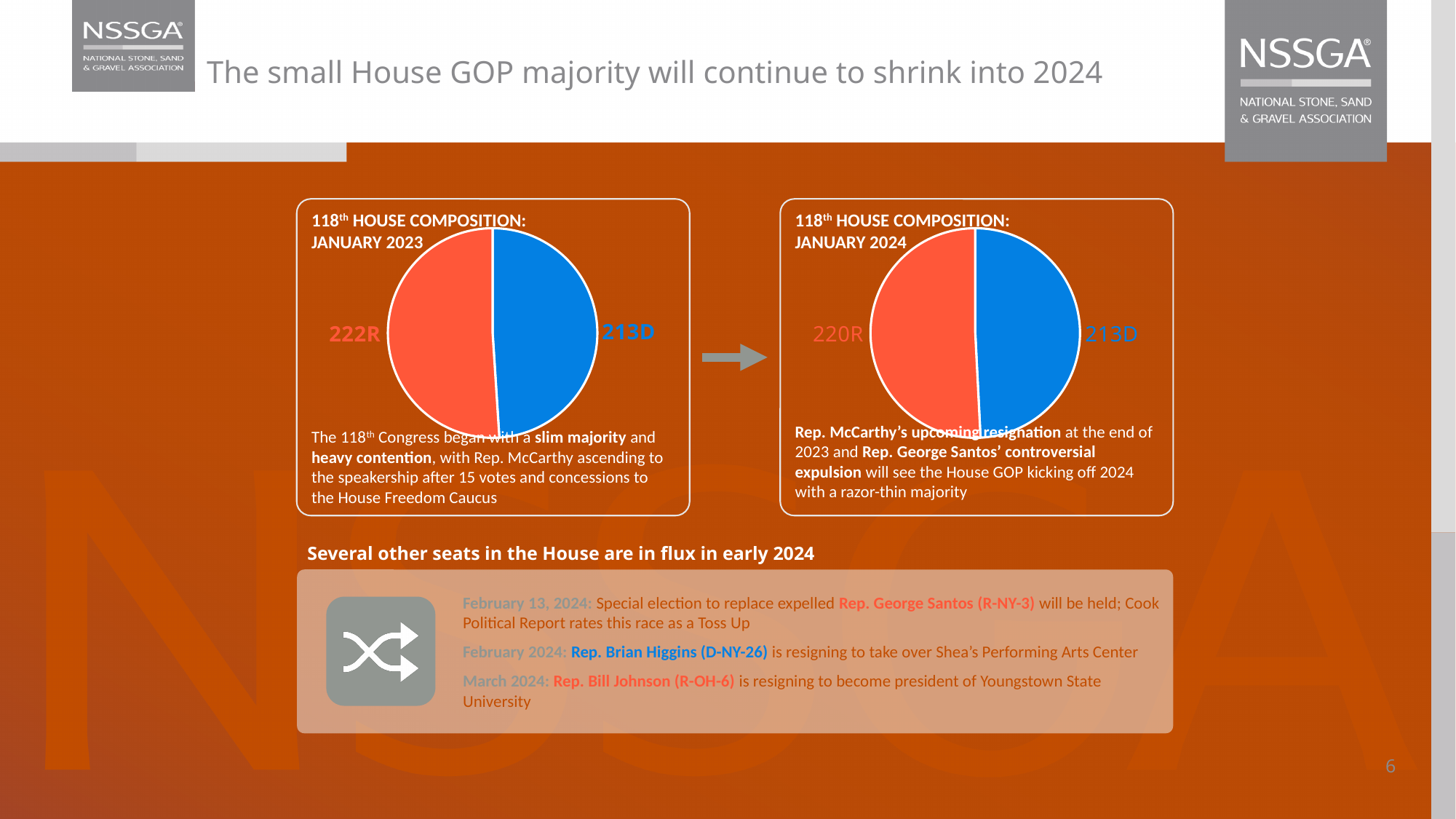
In the January 2023 pie chart, how many Democratic seats are shown? 213D In the January 2024 pie chart, how many Democratic seats are shown? 213D What kind of chart is used to show the 118th House composition? Pie chart How many slices does the January 2024 pie chart have? 2 In the January 2024 pie chart, which party has the smaller slice? Democrats (213D) In the January 2023 pie chart, how many Republican seats are shown? 222R In the January 2023 pie chart, which party has the larger slice? Republicans (222R) Is the Republican seat count larger in the January 2023 chart or the January 2024 chart? January 2023 In the January 2024 pie chart, what is the difference between the Republican and Democratic seat counts? 7 In the January 2024 pie chart, how many Republican seats are shown? 220R What is the total number of seats shown in the January 2023 pie chart? 435 In the January 2023 pie chart, what is the difference between the Republican and Democratic seat counts? 9